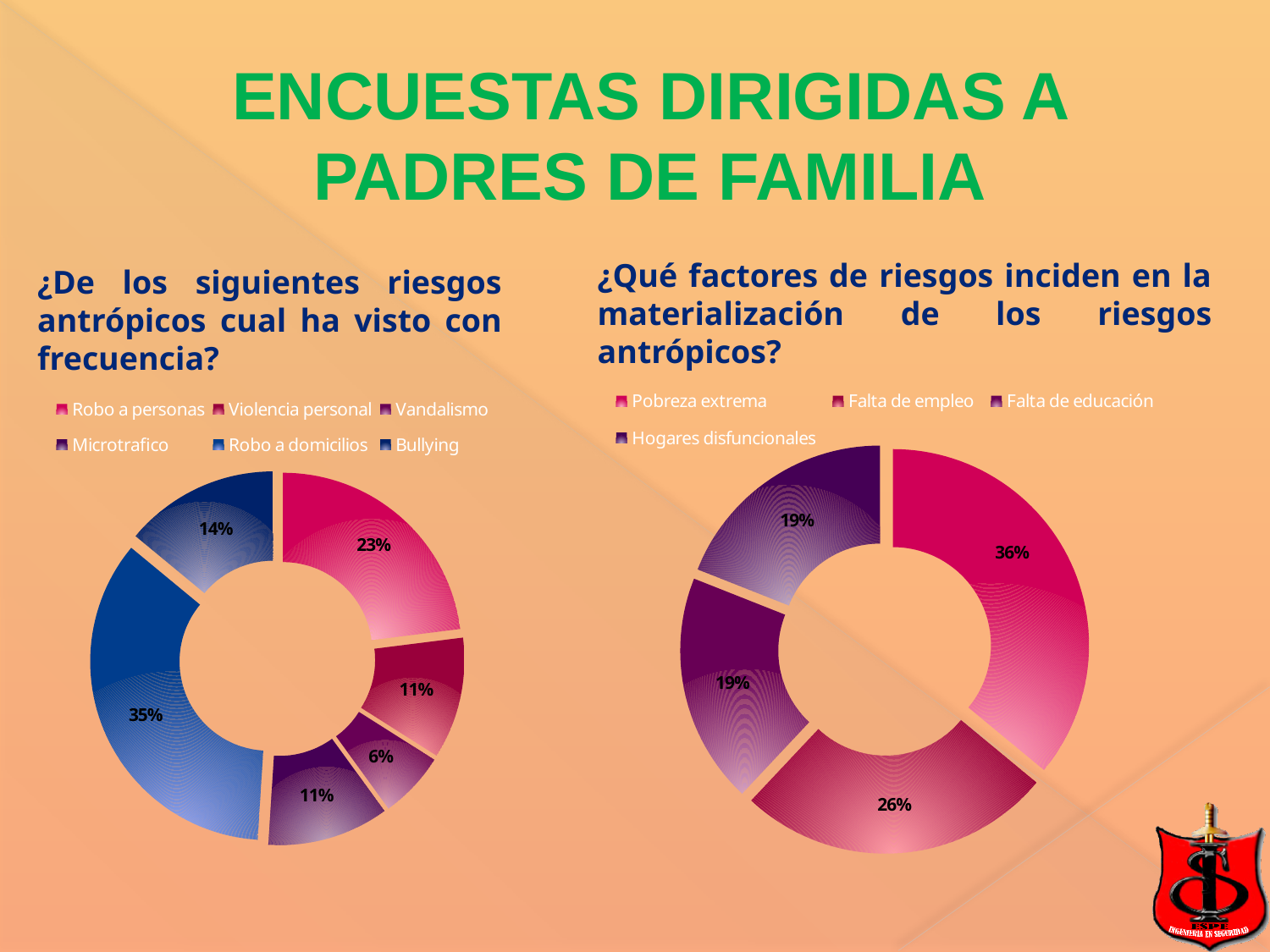
In the left chart (¿De los siguientes riesgos antrópicos cual ha visto con frecuencia?), what percentage is shown for Robo a domicilios? 35% In the right chart (¿Qué factores de riesgos inciden en la materialización de los riesgos antrópicos?), which factor has the largest share? Pobreza extrema In the left chart (¿De los siguientes riesgos antrópicos cual ha visto con frecuencia?), what percentage is shown for Robo a personas? 23% In the left chart (¿De los siguientes riesgos antrópicos cual ha visto con frecuencia?), which category has the smallest share? Vandalismo In the right chart (¿Qué factores de riesgos inciden en la materialización de los riesgos antrópicos?), how many categories does the legend list? 4 In the left chart (¿De los siguientes riesgos antrópicos cual ha visto con frecuencia?), how many categories does the legend list? 6 What type of chart is used for both charts on the slide? Doughnut (pie) chart In the right chart (¿Qué factores de riesgos inciden en la materialización de los riesgos antrópicos?), which is larger, Pobreza extrema or Falta de empleo? Pobreza extrema In the right chart (¿Qué factores de riesgos inciden en la materialización de los riesgos antrópicos?), what percentage is shown for Falta de empleo? 26% In the right chart (¿Qué factores de riesgos inciden en la materialización de los riesgos antrópicos?), what percentage is shown for Pobreza extrema? 36% In the left chart (¿De los siguientes riesgos antrópicos cual ha visto con frecuencia?), what is the difference in percentage points between Robo a domicilios and Bullying? 21 In the left chart (¿De los siguientes riesgos antrópicos cual ha visto con frecuencia?), which category has the largest share? Robo a domicilios